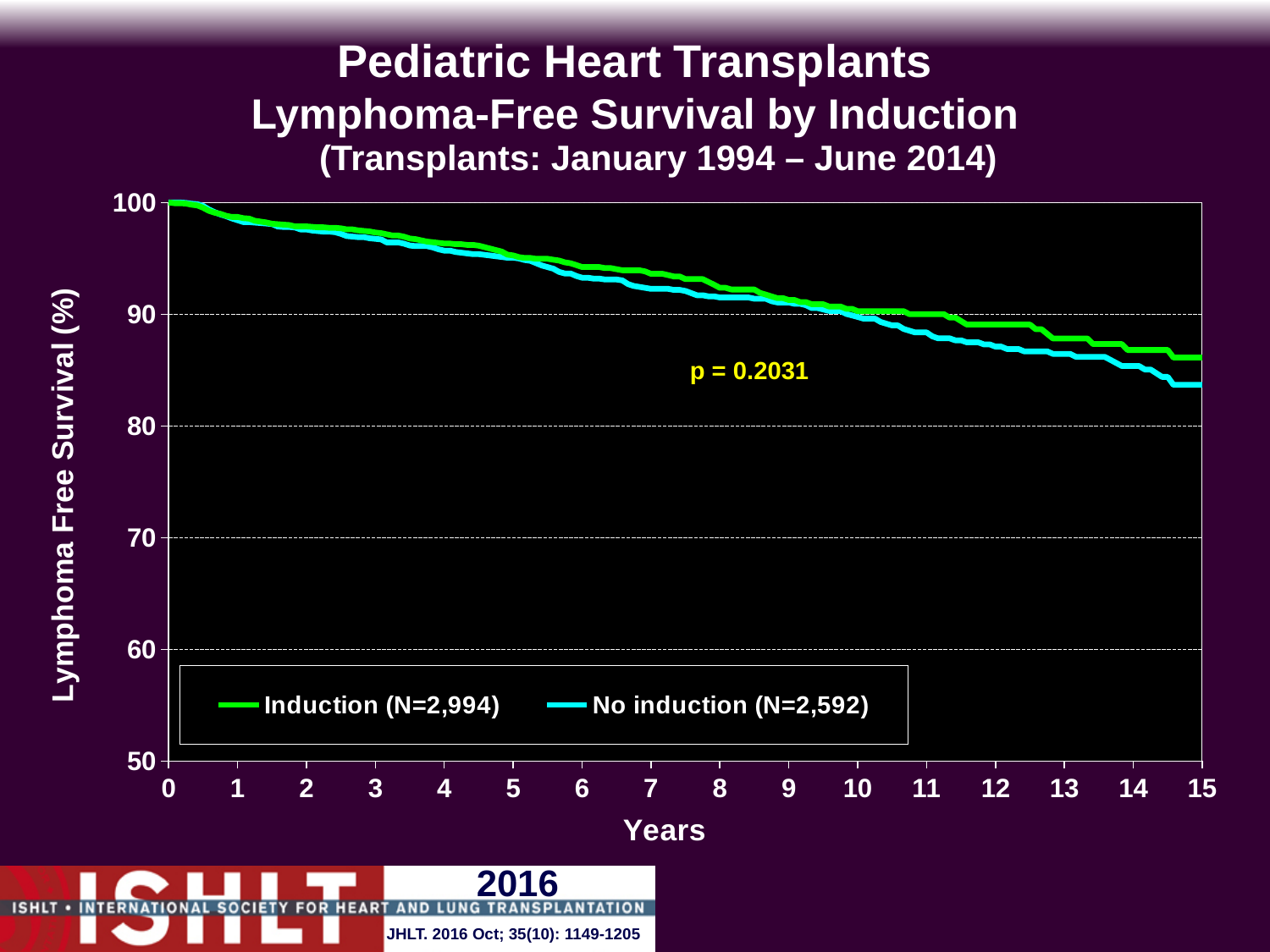
At 5 years, is the value for Induction greater or less than 90? greater How many series does the legend list? 2 At 15 years, is the value for No induction greater or less than 90? less At 15 years, which series has the higher lymphoma-free survival, Induction or No induction? Induction What is the N for the Induction group shown in the legend? N=2,994 What kind of chart is shown on the slide? Line chart Do the lymphoma-free survival curves rise or fall as the years increase? Fall What is the label of the x axis? Years What p-value is printed on the chart? p = 0.2031 What is the highest value shown on the y axis? 100 What is the N for the No induction group shown in the legend? N=2,592 At 15 years, is the value for Induction greater or less than 80? greater